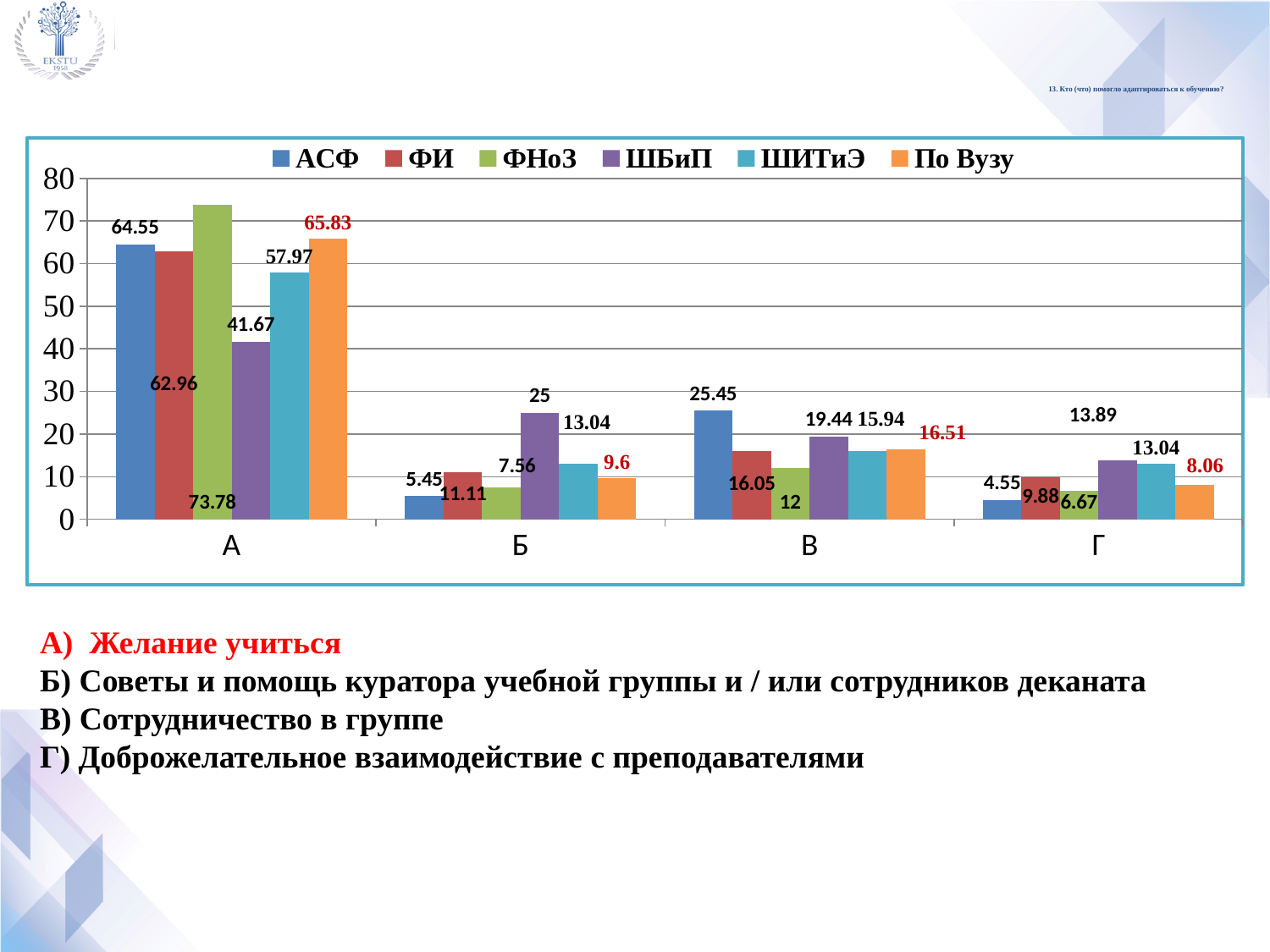
Which series has the highest value in category А? ФНоЗ What is the value for ШБиП in category Б? 25 Which series has the lowest value in category Б? АСФ What kind of chart is shown on the slide? Bar chart What is the value for ФНоЗ in category А? 73.78 In category Г, which is larger: the value for ШБиП or the value for ШИТиЭ? ШБиП What is the value for По Вузу in category В? 16.51 How many categories are shown on the x axis? 4 What is the difference between the АСФ and ФИ values in category В? 9.4 How many series does the legend list? 6 Which colour represents the По Вузу series in the legend? Orange What is the value for АСФ in category Г? 4.55